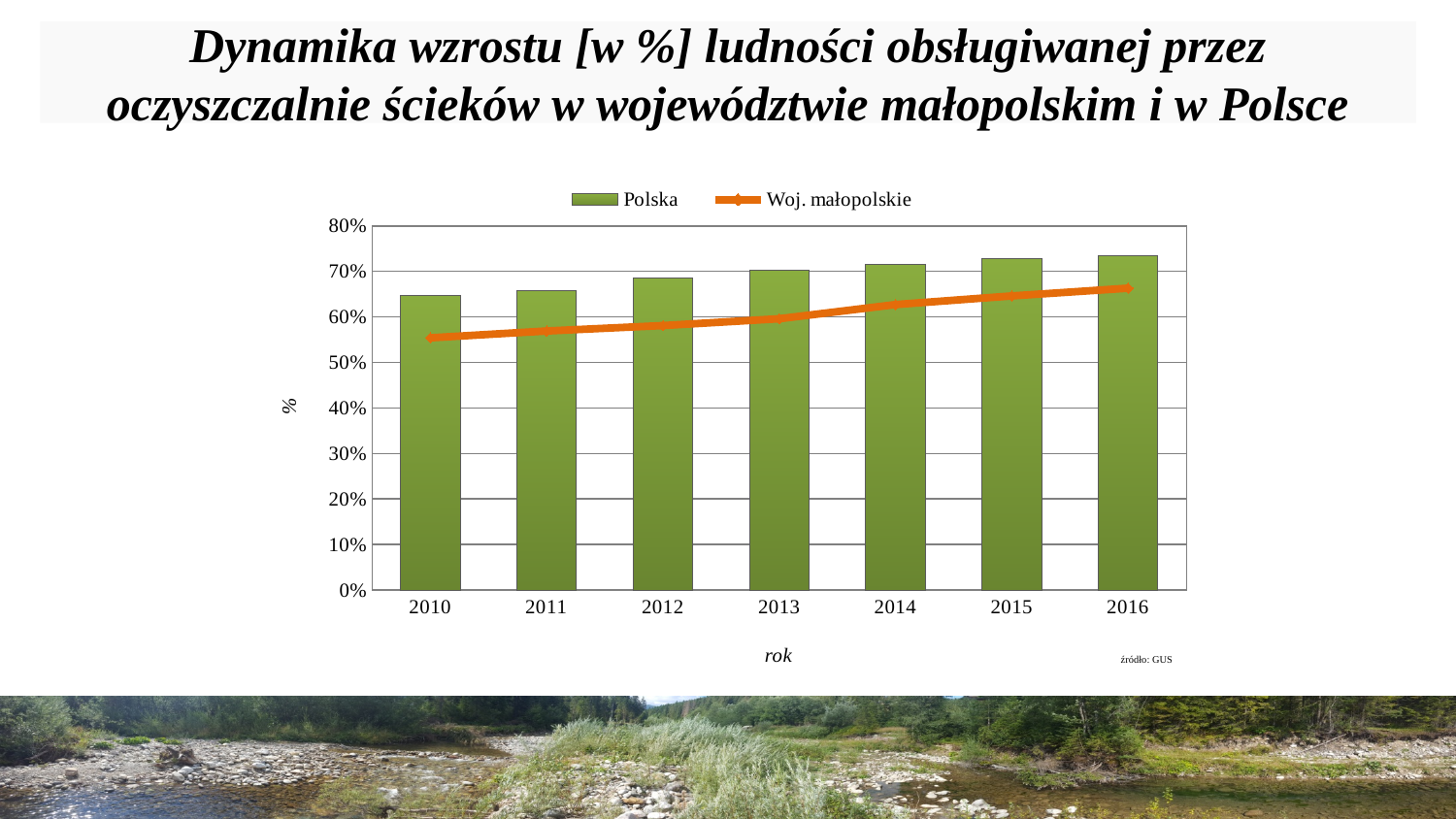
Is the Polska value for 2016 greater or less than 70%? greater How many series does the legend list? 2 Is the Polska value for 2010 greater or less than 60%? greater In which year is the Woj. małopolskie value the lowest? 2010 In 2010, which is larger: the value for Polska or for Woj. małopolskie? Polska What kind of chart is this? A combined bar and line chart Do the Woj. małopolskie values rise or fall from 2010 to 2016? rise In which year is the Polska bar the highest? 2016 In which year is the Polska bar the lowest? 2010 What are the two series named in the legend? Polska and Woj. małopolskie How many years are shown on the x axis? 7 Is the Woj. małopolskie value for 2010 greater or less than 60%? less